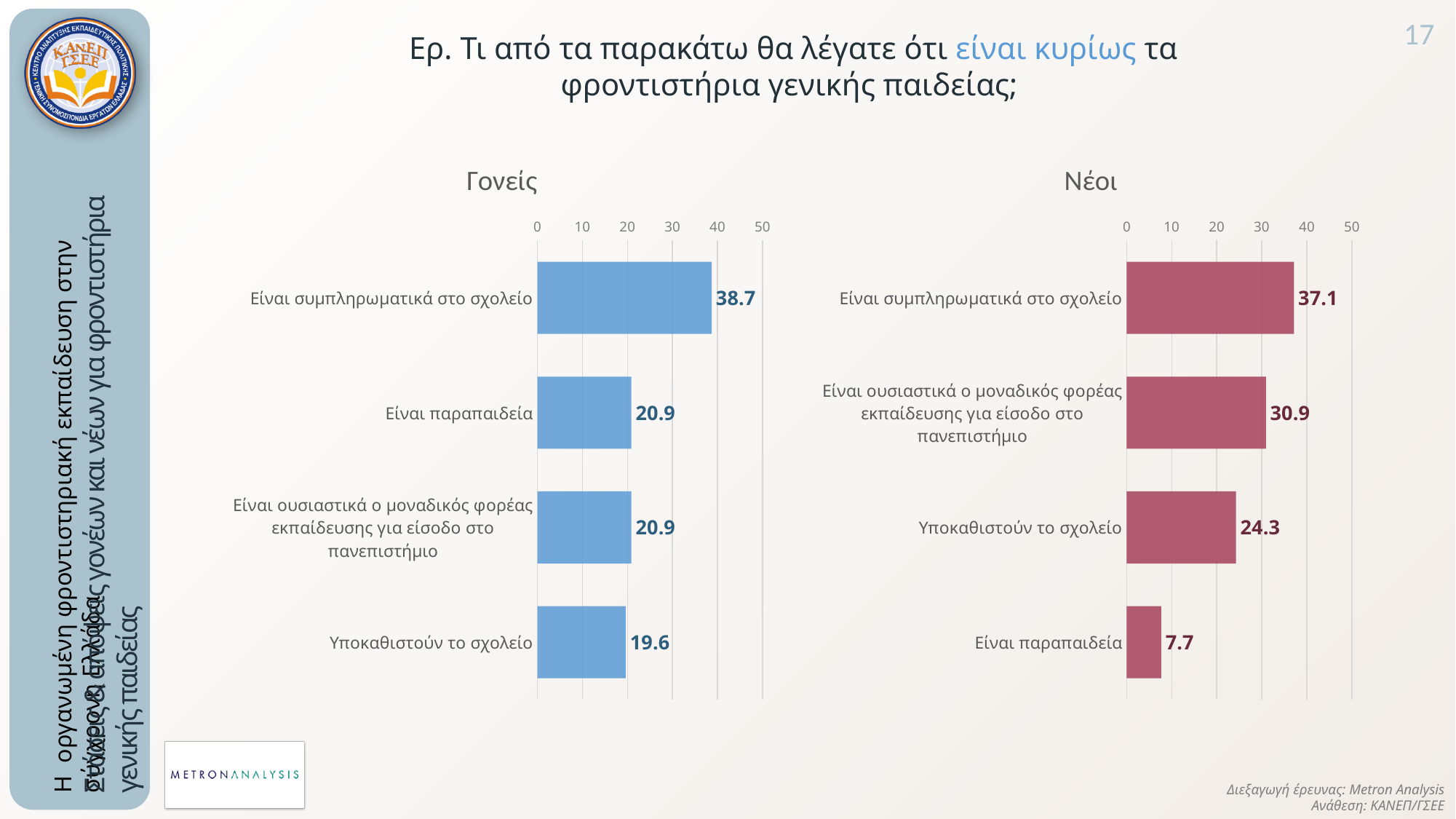
What kind of chart is the Νέοι chart? Bar chart In the Νέοι chart, what is the value for 'Είναι παραπαιδεία'? 7.7 How many categories does the Γονείς chart show? 4 Which is larger: 'Είναι παραπαιδεία' in the Γονείς chart or 'Είναι παραπαιδεία' in the Νέοι chart? Γονείς In the Νέοι chart, which category has the lowest value? Είναι παραπαιδεία In the Νέοι chart, what is the difference between 'Είναι ουσιαστικά ο μοναδικός φορέας εκπαίδευσης για είσοδο στο πανεπιστήμιο' and 'Είναι παραπαιδεία'? 23.2 What colour are the bars in the Γονείς chart? Blue In the Νέοι chart, what is the value for 'Υποκαθιστούν το σχολείο'? 24.3 What is the difference between the values for 'Είναι συμπληρωματικά στο σχολείο' in the Γονείς chart and in the Νέοι chart? 1.6 In the Νέοι chart, which category has the highest value? Είναι συμπληρωματικά στο σχολείο In the Γονείς chart, what is the value for 'Είναι συμπληρωματικά στο σχολείο'? 38.7 In the Γονείς chart, which category has the lowest value? Υποκαθιστούν το σχολείο